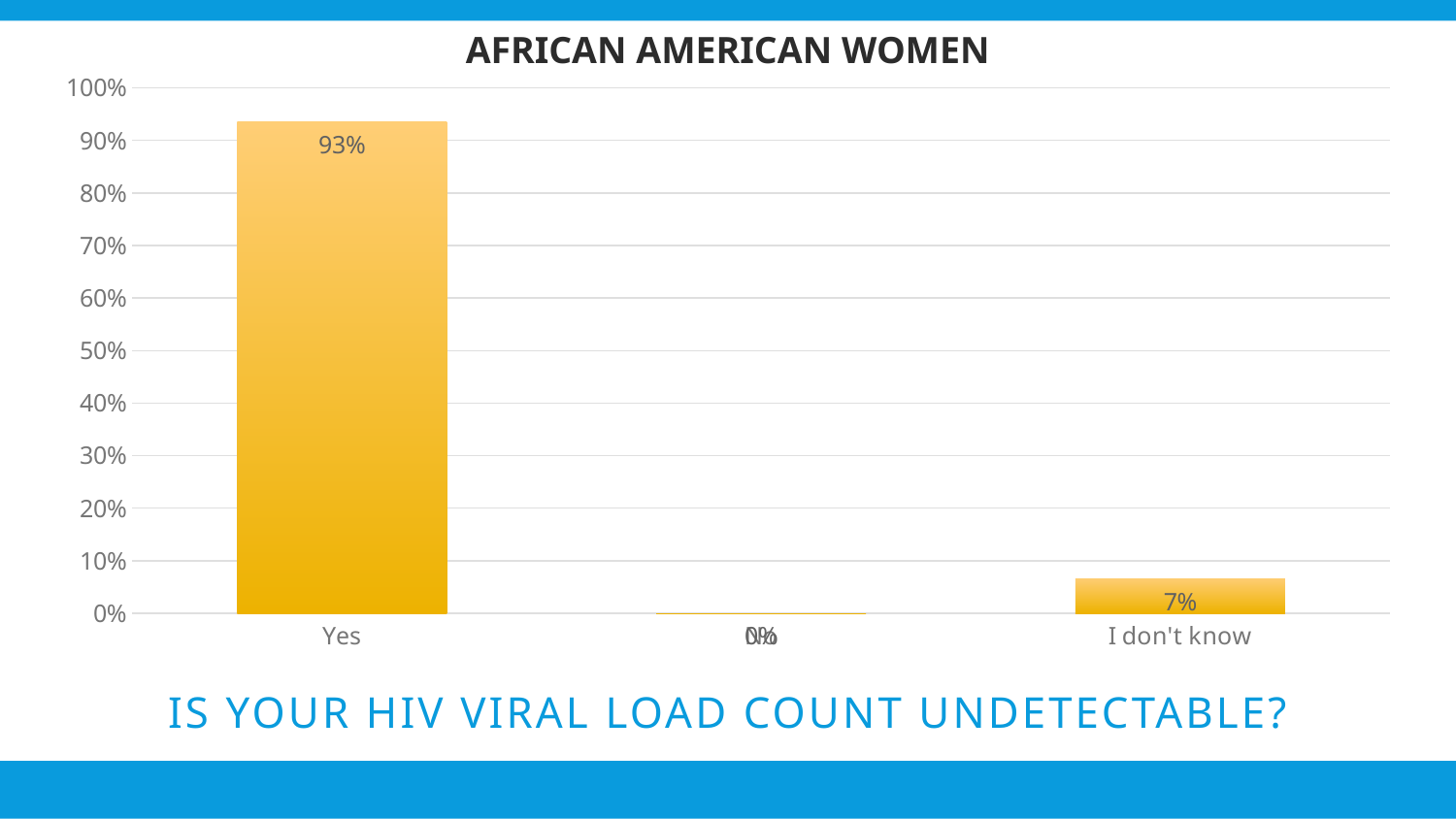
What kind of chart is shown on the slide? bar chart How many categories are shown on the x axis? 3 What is the highest value shown on the y axis? 100% Which is larger, the value for Yes or the value for I don't know? Yes What is the difference between the values for Yes and I don't know? 86% What question is the chart answering, as written below it? IS YOUR HIV VIRAL LOAD COUNT UNDETECTABLE? Is the value for I don't know greater or less than 10%? less What is the value for Yes? 93% Is the value for Yes greater or less than 90%? greater Which category has the highest value? Yes What is the title of the chart? AFRICAN AMERICAN WOMEN What is the value for I don't know? 7%